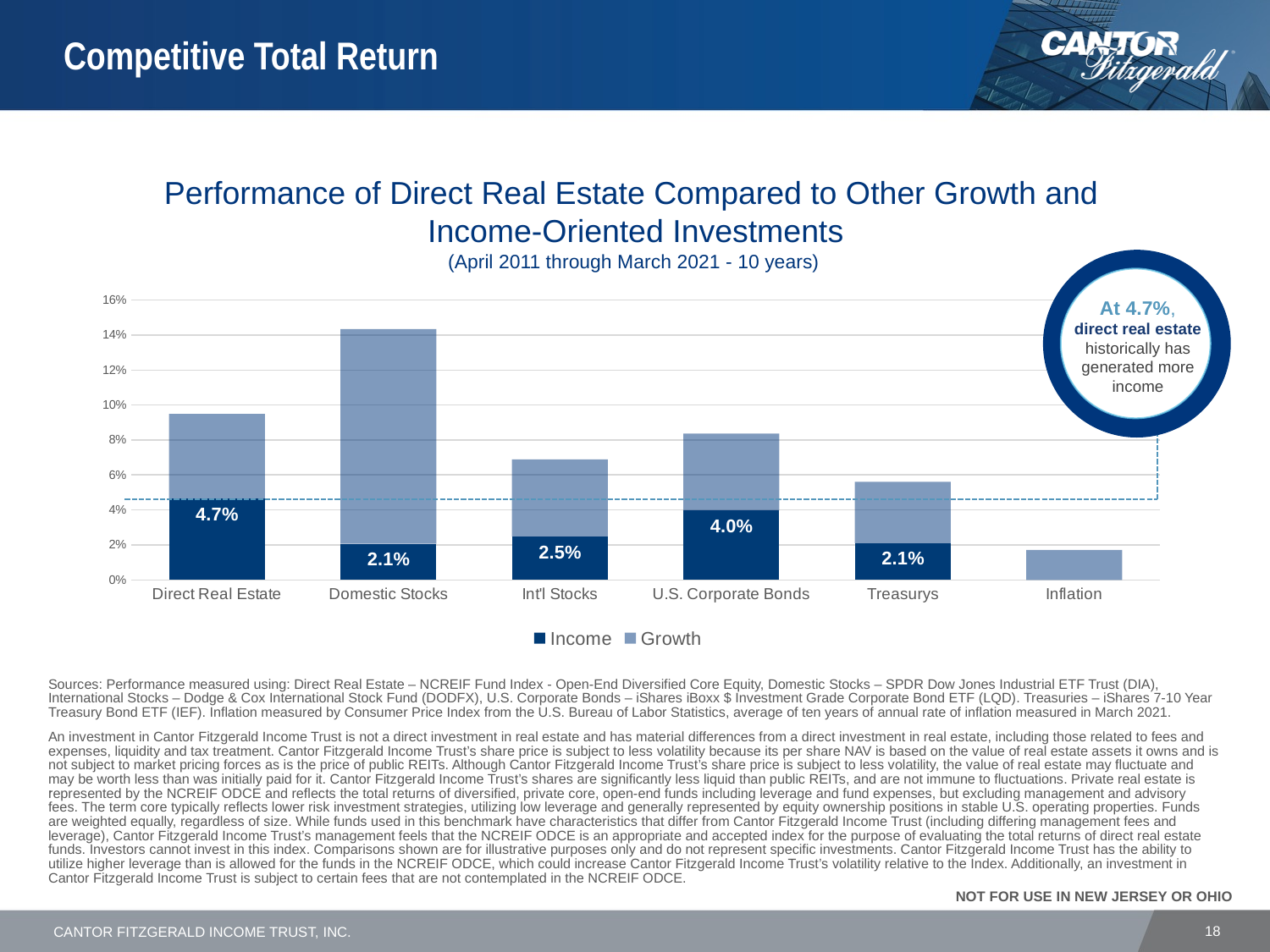
What is the Income value for Treasurys? 2.1% Which category has the highest Income value? Direct Real Estate What is the Income value for Direct Real Estate? 4.7% Which has a larger Income value, Int'l Stocks or Domestic Stocks? Int'l Stocks How many series does the legend list? 2 What is the difference between the Income values for Direct Real Estate and U.S. Corporate Bonds? 0.7% How many categories are shown on the x axis? 6 What is the Income value for U.S. Corporate Bonds? 4.0% Which category has the tallest total bar? Domestic Stocks What is the Income value for Int'l Stocks? 2.5% Is the total bar for Domestic Stocks greater or less than 12%? greater Which category has the shortest total bar? Inflation